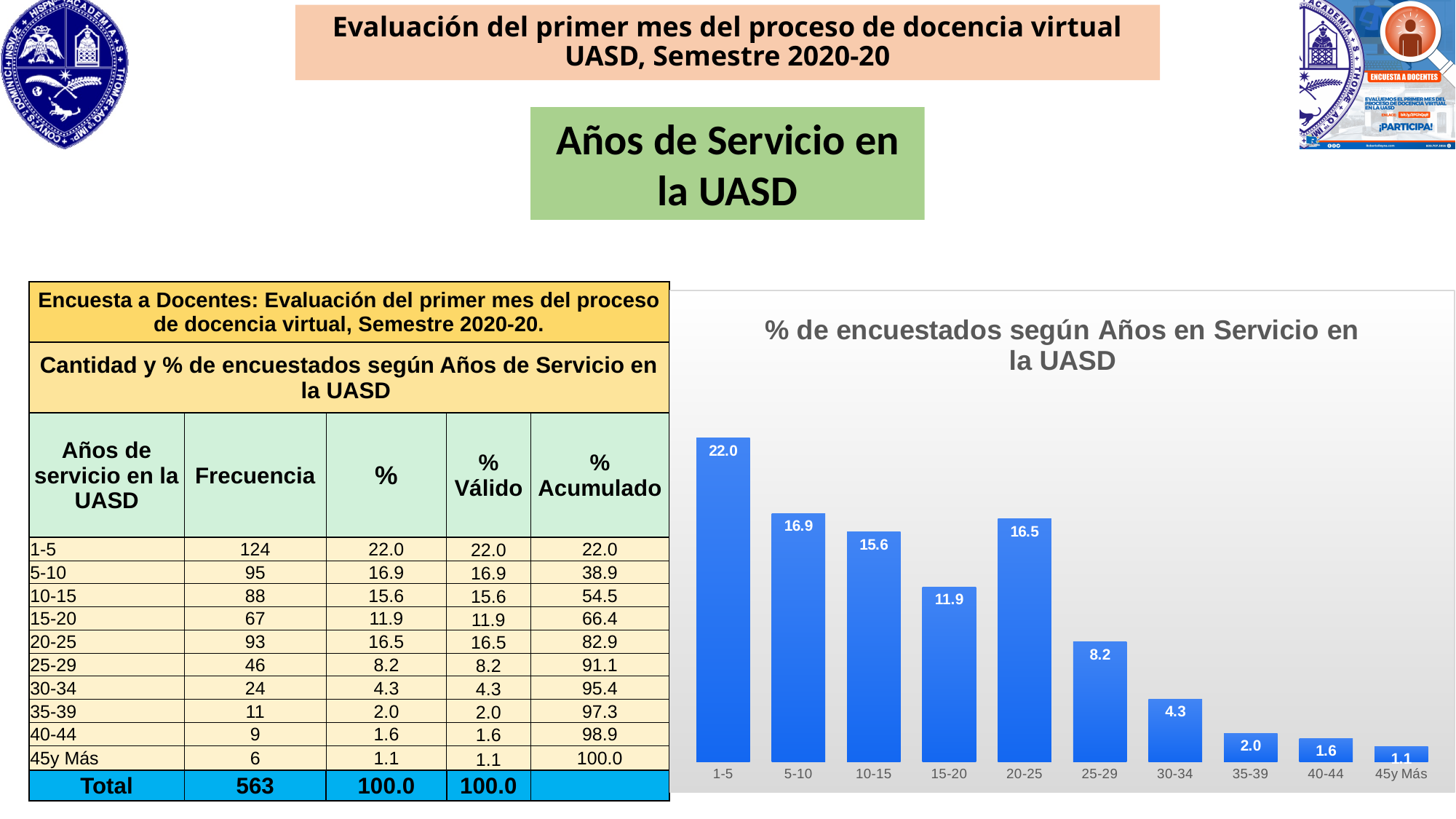
What is the value for the 20-25 category in the chart? 16.5 What is the difference between the values for 1-5 and 5-10? 5.1 Which category has the highest value in the chart? 1-5 What is the value for the 1-5 category in the chart? 22.0 What kind of chart is shown on the slide? bar chart What is the value for the 30-34 category in the chart? 4.3 Which is larger, the value for 5-10 or the value for 20-25? 5-10 How many categories are shown on the x axis of the chart? 10 What is the title of the chart? % de encuestados según Años en Servicio en la UASD What is the difference between the values for 20-25 and 15-20? 4.6 Which is larger, the value for 10-15 or the value for 25-29? 10-15 Which category has the lowest value in the chart? 45y Más